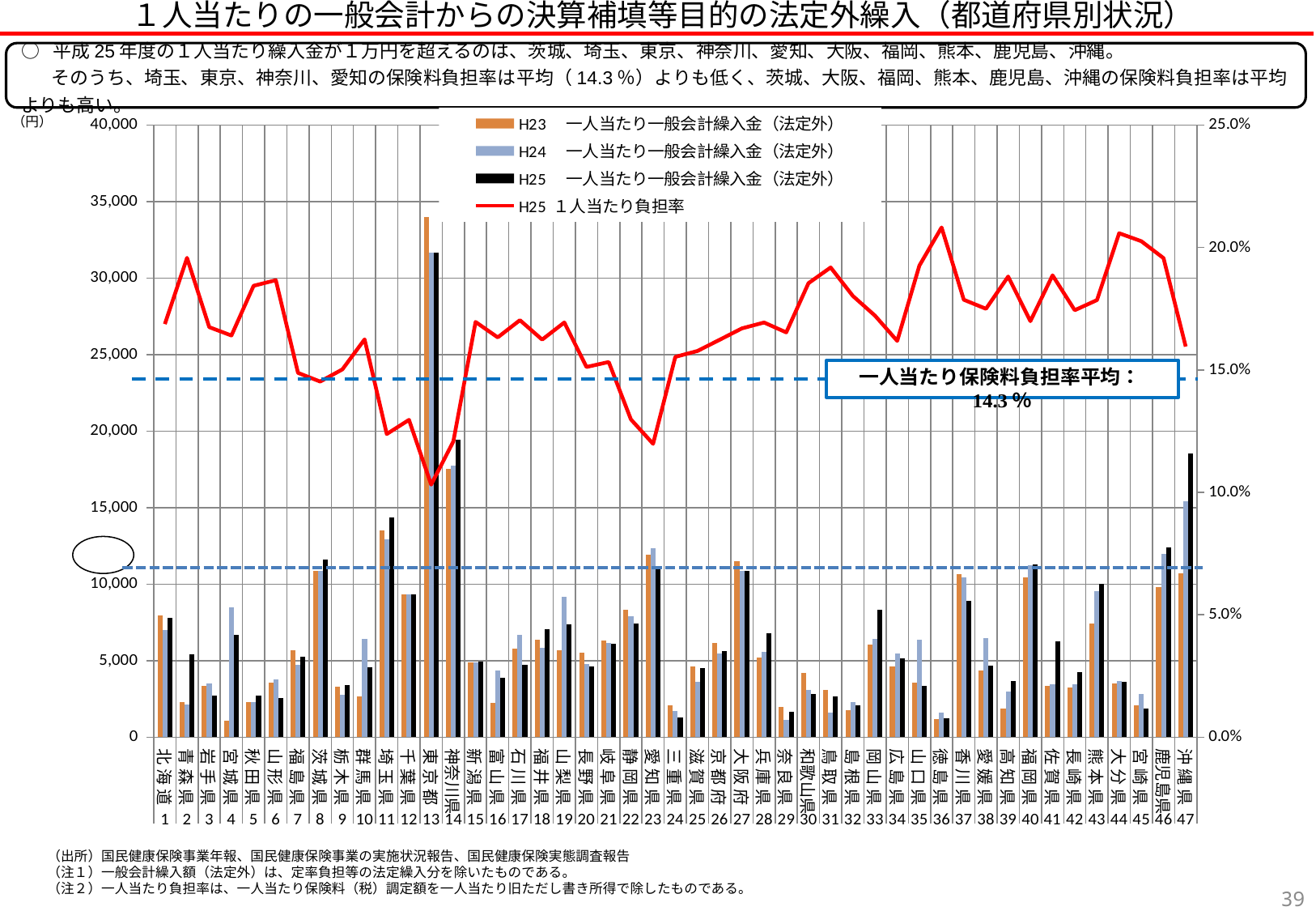
Which is larger for 東京都: the H23 bar or the H25 bar? H23 How many series does the legend list? 4 Is the H23 value for 東京都 greater or less than 30,000? greater What value is given for the 一人当たり保険料負担率平均 shown in the box on the chart? 14.3％ Is the H25 １人当たり負担率 for 東京都 greater or less than 15.0%? less Which prefecture has the highest H23 一人当たり一般会計繰入金 bar? 東京都 How many prefectures (categories) are plotted along the x axis? 47 Which prefecture has the larger H25 bar, 埼玉県 or 千葉県? 埼玉県 What kind of chart is shown on the slide? A combined bar and line chart Is the H25 value for 沖縄県 greater or less than 15,000? greater Which prefecture has the lowest H25 １人当たり負担率 on the red line? 東京都